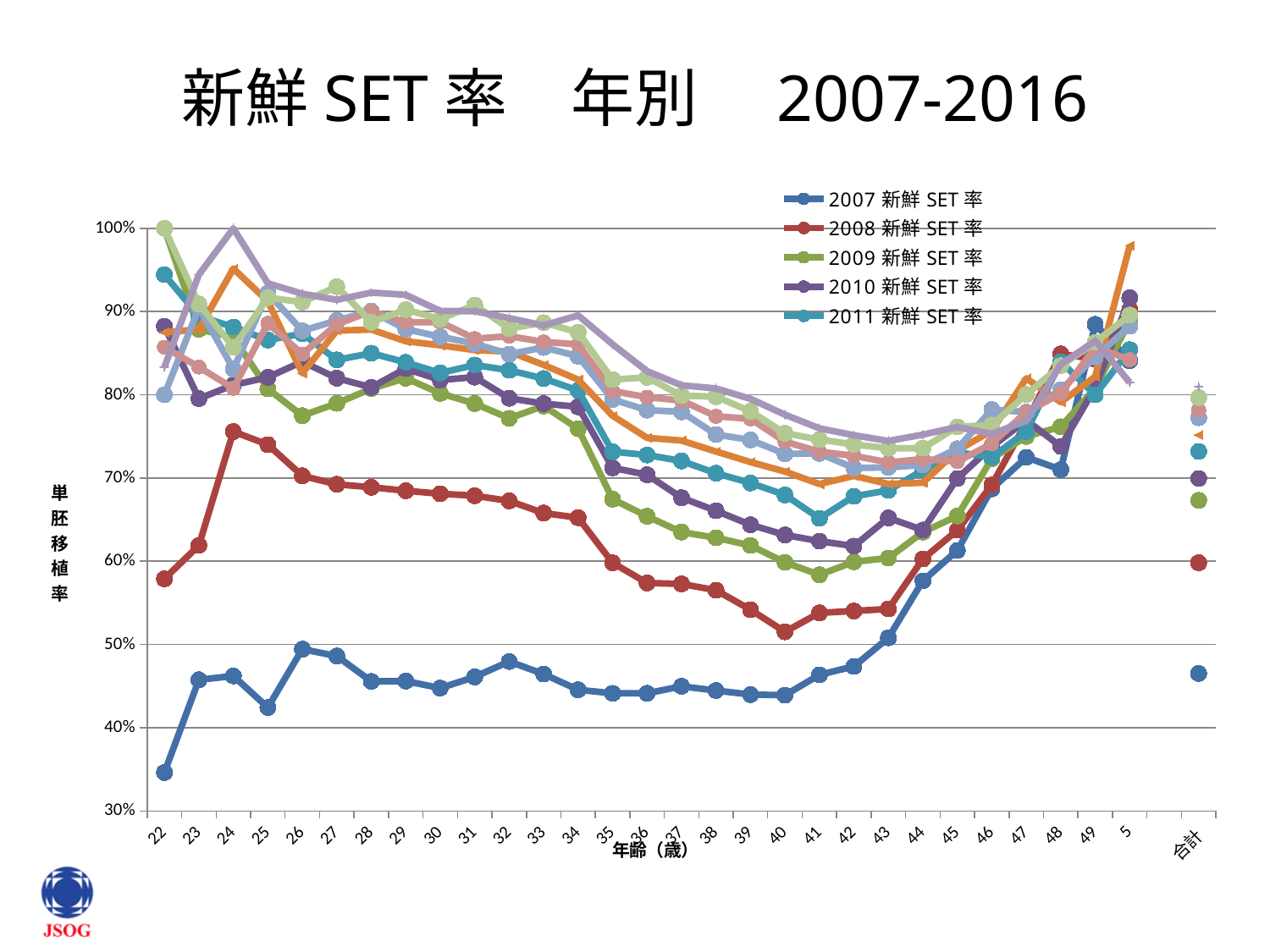
Which of the legend series has the lowest value at age 35? 2007 新鮮 SET 率 How many series does the legend list? 5 At age 30, which is larger: the 2007 新鮮 SET 率 series or the 2008 新鮮 SET 率 series? 2008 新鮮 SET 率 At age 22, which is larger: the 2010 新鮮 SET 率 series or the 2011 新鮮 SET 率 series? 2011 新鮮 SET 率 Is the value for the 2008 新鮮 SET 率 series at age 24 greater or less than 70%? greater What kind of chart is shown on the slide? line chart Is the value for the 2007 新鮮 SET 率 series at age 22 greater or less than 40%? less What is the title of the chart? 新鮮 SET 率 年別 2007-2016 Is the value for the 2007 新鮮 SET 率 series at age 40 greater or less than 50%? less What is the label of the x axis? 年齢（歳） Does the 2007 新鮮 SET 率 series rise or fall from age 40 to age 49? rise